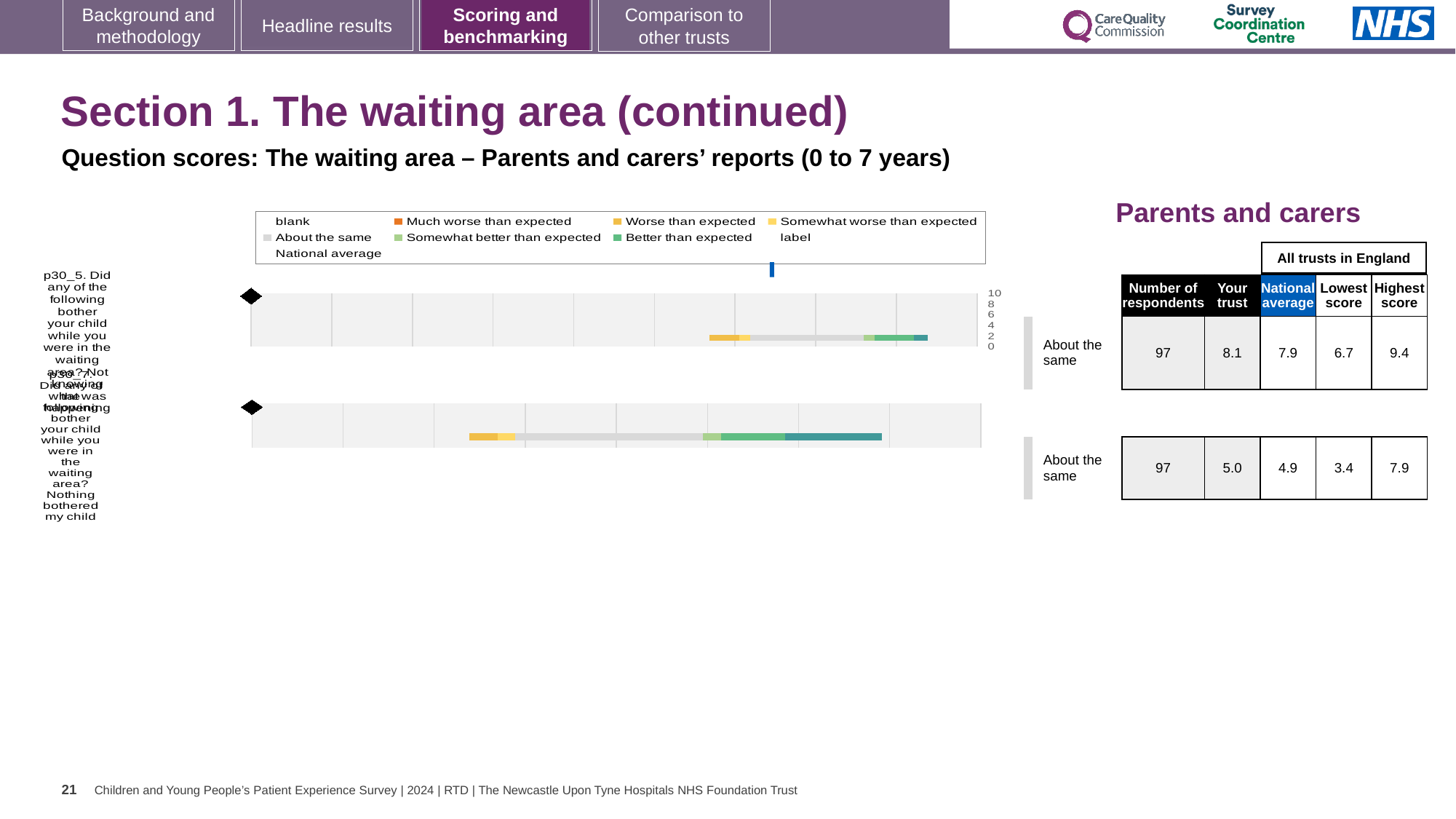
How many question bars are plotted in the chart? 2 What is the difference between the highest score and the lowest score for question p30_5? 2.7 What colour does the legend use for 'Much worse than expected'? orange How many respondents are listed for question p30_5? 97 What kind of chart is shown on the slide? bar chart What is the lowest score across all trusts in England for question p30_7? 3.4 According to the table beside the chart, what is the 'Your trust' score for question p30_5 (Not knowing what was happening)? 8.1 According to the table beside the chart, what is the national average for question p30_7 (Nothing bothered my child)? 4.9 Which question has the higher 'Your trust' score, p30_5 or p30_7? p30_5 By how much does the trust's score for p30_7 exceed the national average? 0.1 What is the difference between the highest scores of p30_5 and p30_7? 1.5 What benchmark category is shown for both questions on the slide? About the same